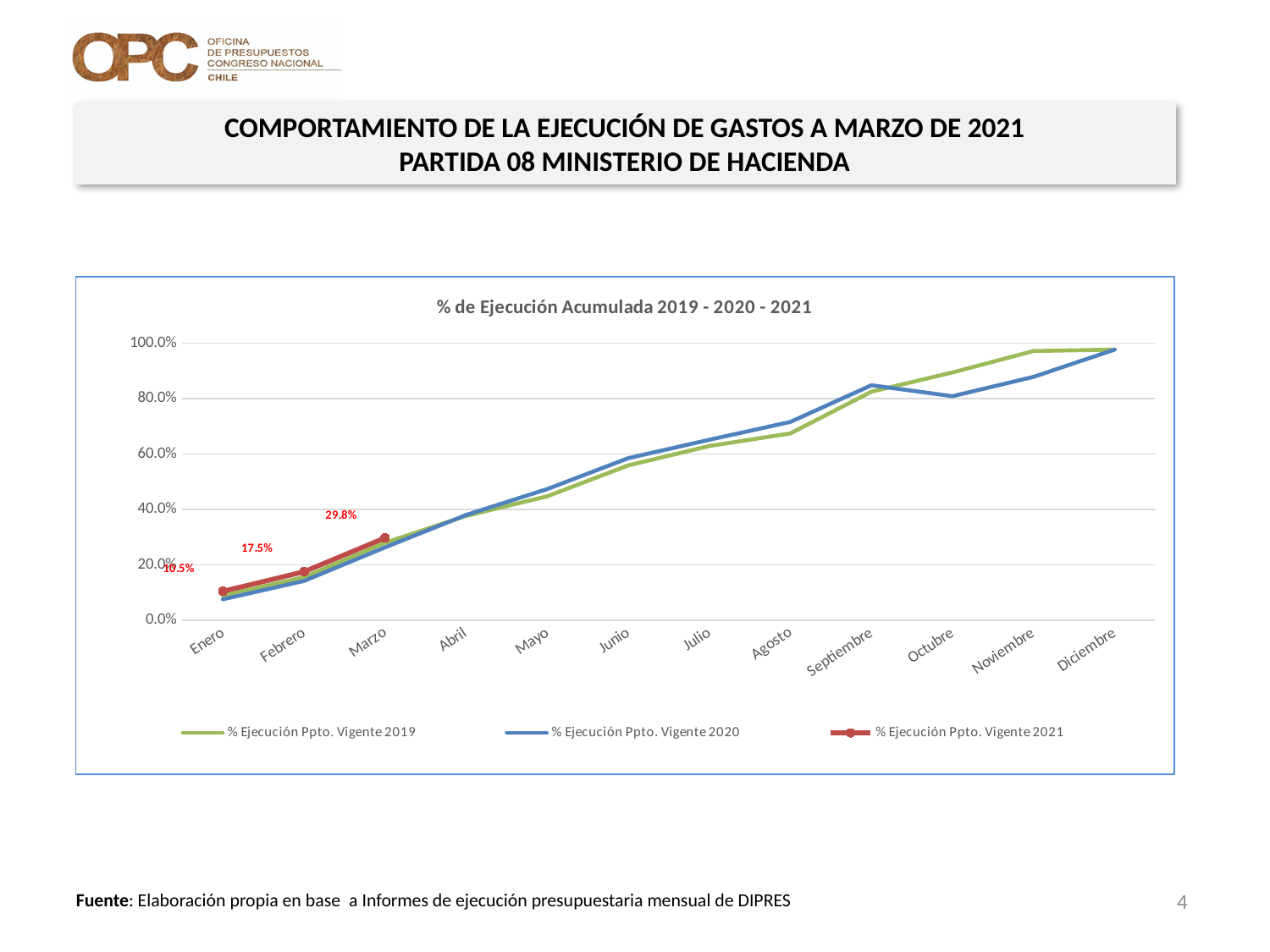
In Noviembre, which series is higher: % Ejecución Ppto. Vigente 2019 or % Ejecución Ppto. Vigente 2020? % Ejecución Ppto. Vigente 2019 What is the difference between the 2021 values for Marzo and Febrero? 12.3% What kind of chart is shown on the slide? line chart How many months are shown on the x axis? 12 What is the value of % Ejecución Ppto. Vigente 2021 for Marzo? 29.8% How many series does the legend list? 3 What is the value of % Ejecución Ppto. Vigente 2021 for Febrero? 17.5% What is the difference between the 2021 values for Febrero and Enero? 7.0% Does the % Ejecución Ppto. Vigente 2021 series rise or fall from Enero to Marzo? rise Is the value for % Ejecución Ppto. Vigente 2019 in Agosto greater or less than 80%? less What is the title of the chart? % de Ejecución Acumulada 2019 - 2020 - 2021 What is the value of % Ejecución Ppto. Vigente 2021 for Enero? 10.5%